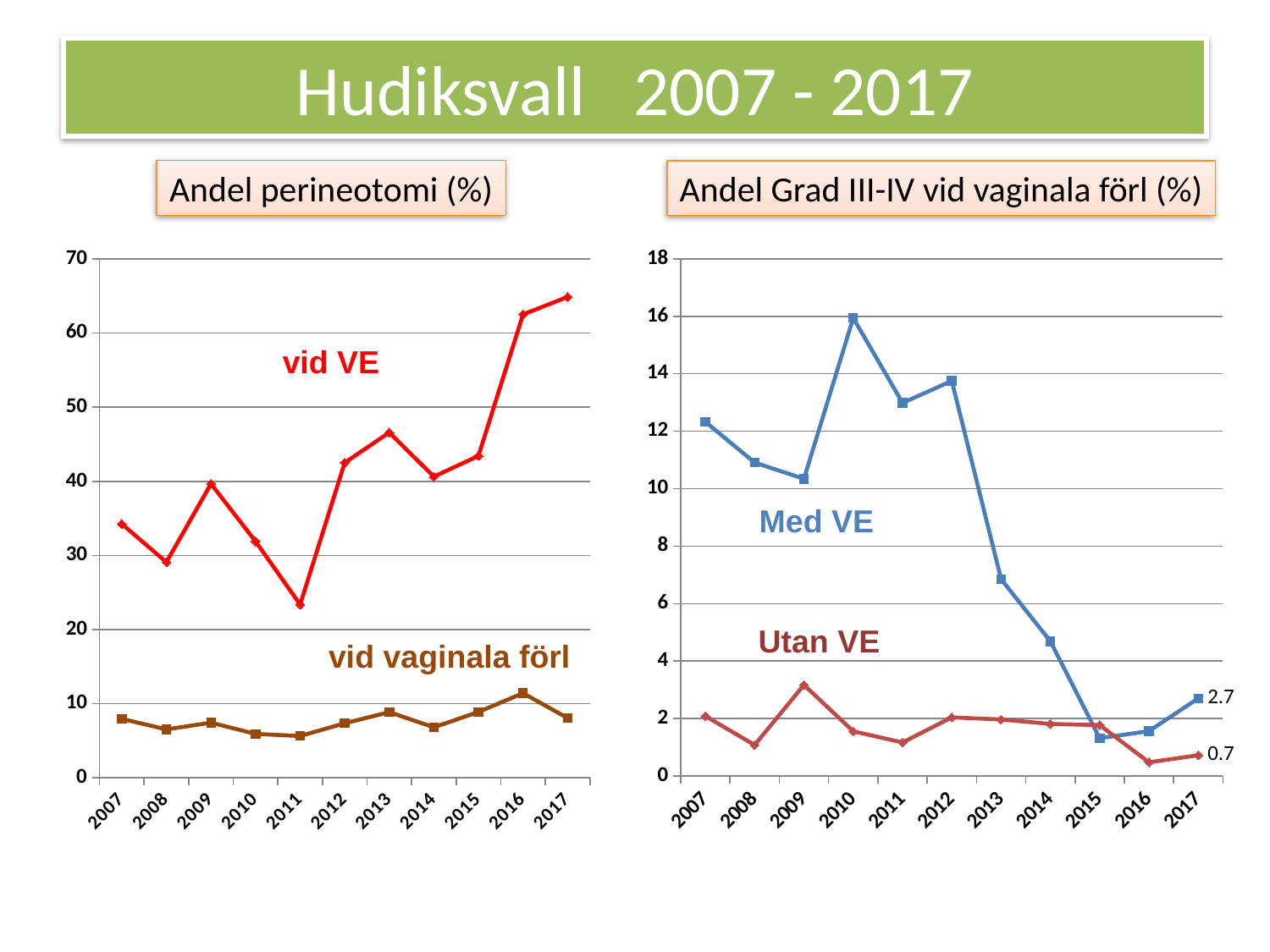
On the chart titled 'Andel perineotomi (%)', is the 'vid VE' value for 2017 greater or less than 60? greater How many years are shown on the x axis of the chart titled 'Andel perineotomi (%)'? 11 What kind of chart is the left chart, 'Andel perineotomi (%)'? Line chart On the chart titled 'Andel Grad III-IV vid vaginala förl (%)', what is the difference between the Med VE and Utan VE values in 2017? 2.0 On the chart titled 'Andel Grad III-IV vid vaginala förl (%)', what is the value for Med VE in 2017? 2.7 On the chart titled 'Andel Grad III-IV vid vaginala förl (%)', which series has the larger value in 2017, Med VE or Utan VE? Med VE On the chart titled 'Andel Grad III-IV vid vaginala förl (%)', in which year is the Med VE series highest? 2010 On the chart titled 'Andel Grad III-IV vid vaginala förl (%)', does the Med VE series overall rise or fall from 2007 to 2017? Fall On the chart titled 'Andel Grad III-IV vid vaginala förl (%)', what is the value for Utan VE in 2017? 0.7 How many series are plotted on the chart titled 'Andel Grad III-IV vid vaginala förl (%)'? 2 On the chart titled 'Andel perineotomi (%)', in which year is the 'vid VE' series lowest? 2011 On the chart titled 'Andel Grad III-IV vid vaginala förl (%)', is the Med VE value for 2010 greater or less than 14? greater